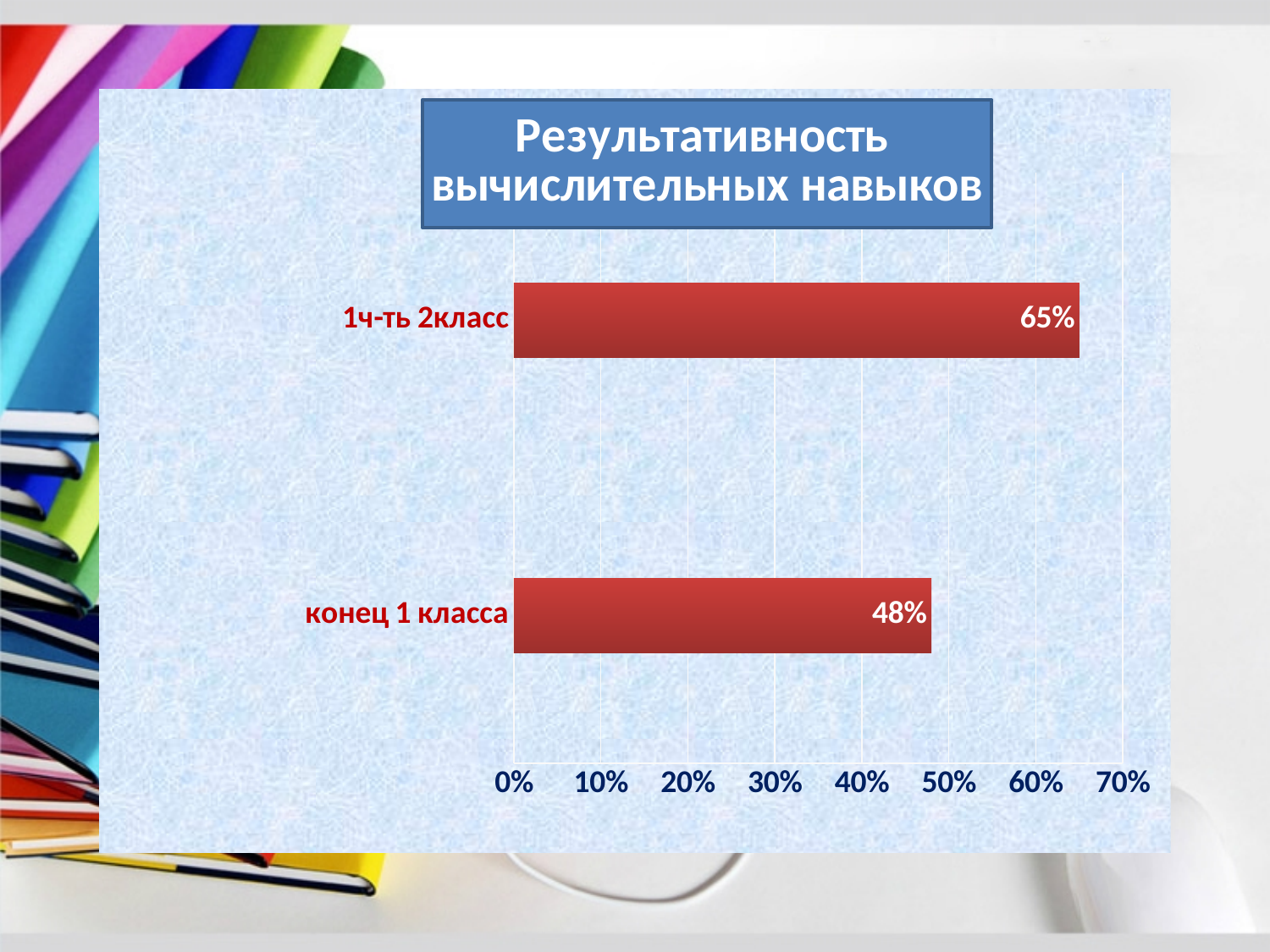
What is the value for конец 1 класса? 48% How many categories are shown in the chart? 2 What is the title of the chart? Результативность вычислительных навыков Is the value for 1ч-ть 2класс greater or less than 60%? greater What is the highest value shown on the horizontal axis? 70% Which category has the highest value? 1ч-ть 2класс What is the value for 1ч-ть 2класс? 65% Which category has the lowest value? конец 1 класса Is the value for конец 1 класса greater or less than 50%? less What is the difference between the values for 1ч-ть 2класс and конец 1 класса? 17% Which is larger, the value for конец 1 класса or the value for 1ч-ть 2класс? 1ч-ть 2класс What kind of chart is shown on the slide? bar chart